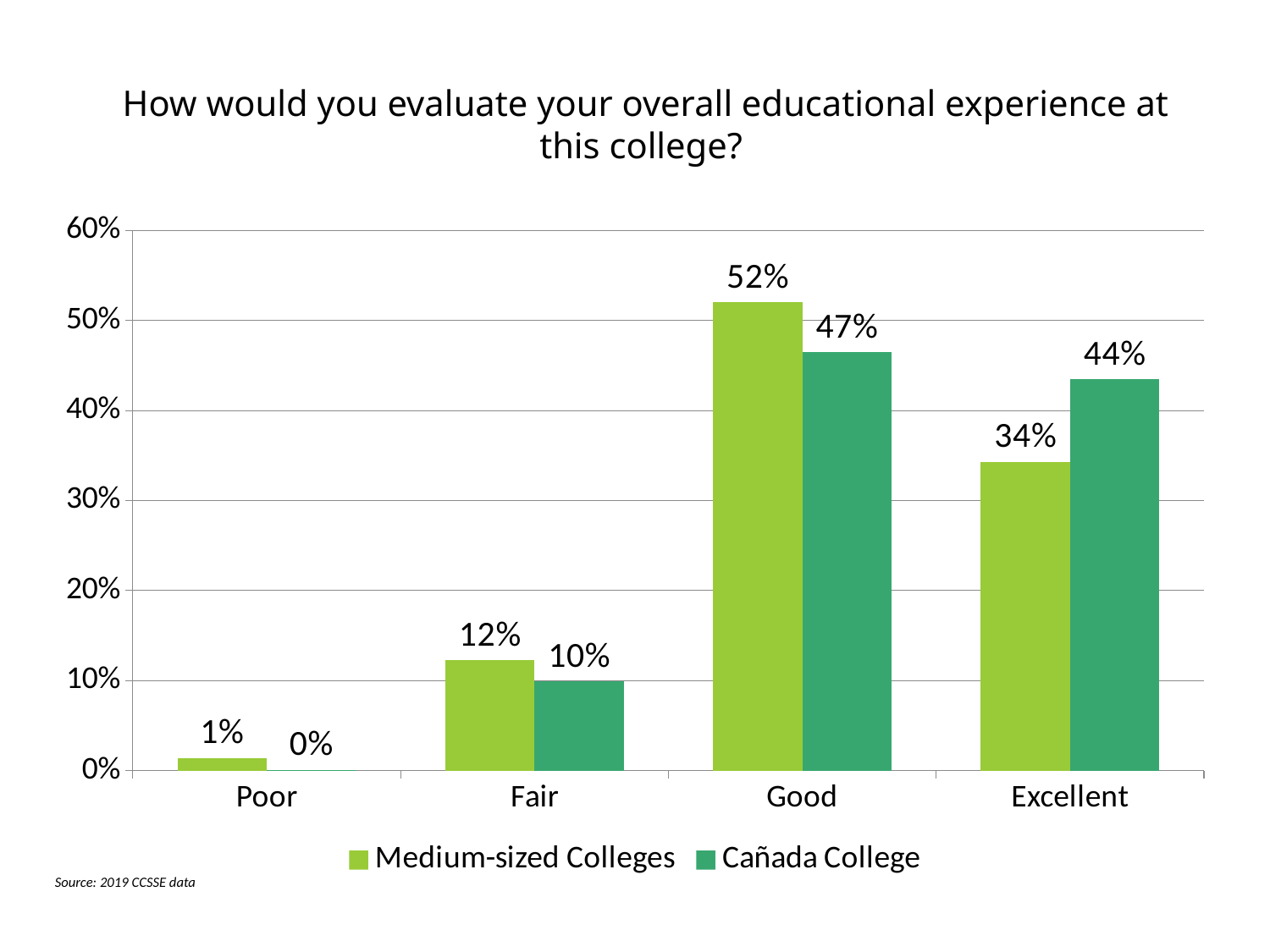
How many categories are shown on the x axis? 4 What kind of chart is shown on the slide? Bar chart What is the difference between Medium-sized Colleges and Cañada College in the Excellent category? 10% In the Good category, which is larger: Medium-sized Colleges or Cañada College? Medium-sized Colleges Which category has the highest value for Cañada College? Good What is the value for Medium-sized Colleges in the Poor category? 1% How many series does the legend list? 2 What is the value for Cañada College in the Fair category? 10% Which category has the lowest value for Medium-sized Colleges? Poor What is the value for Cañada College in the Excellent category? 44% What is the value for Medium-sized Colleges in the Good category? 52% Is the value for Cañada College in the Good category greater or less than 40%? greater